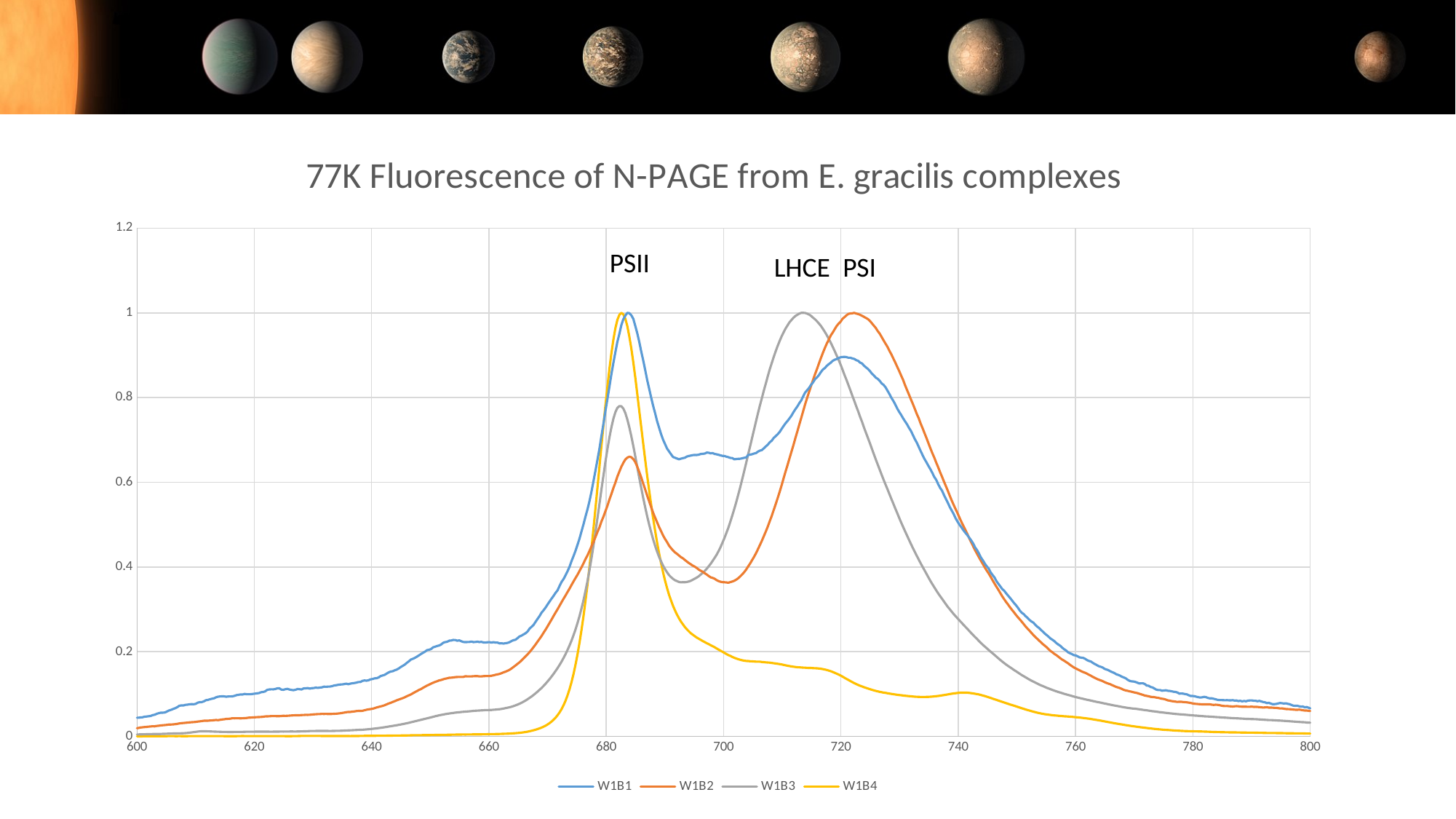
At 740, which series has the larger value, W1B2 or W1B3? W1B2 Is the value for W1B3 at 760 greater or less than 0.2? less How many series does the legend list? 4 Which series is drawn in yellow? W1B4 What kind of chart is shown on the slide? line chart Is the value for W1B4 at 740 greater or less than 0.2? less At 700, which series has the larger value, W1B1 or W1B4? W1B1 Is the value for W1B2 at 760 greater or less than 0.4? less Which series has the lowest value at 640? W1B4 What is the title of the chart? 77K Fluorescence of N-PAGE from E. gracilis complexes Does the W1B4 series rise or fall between 740 and 800? fall